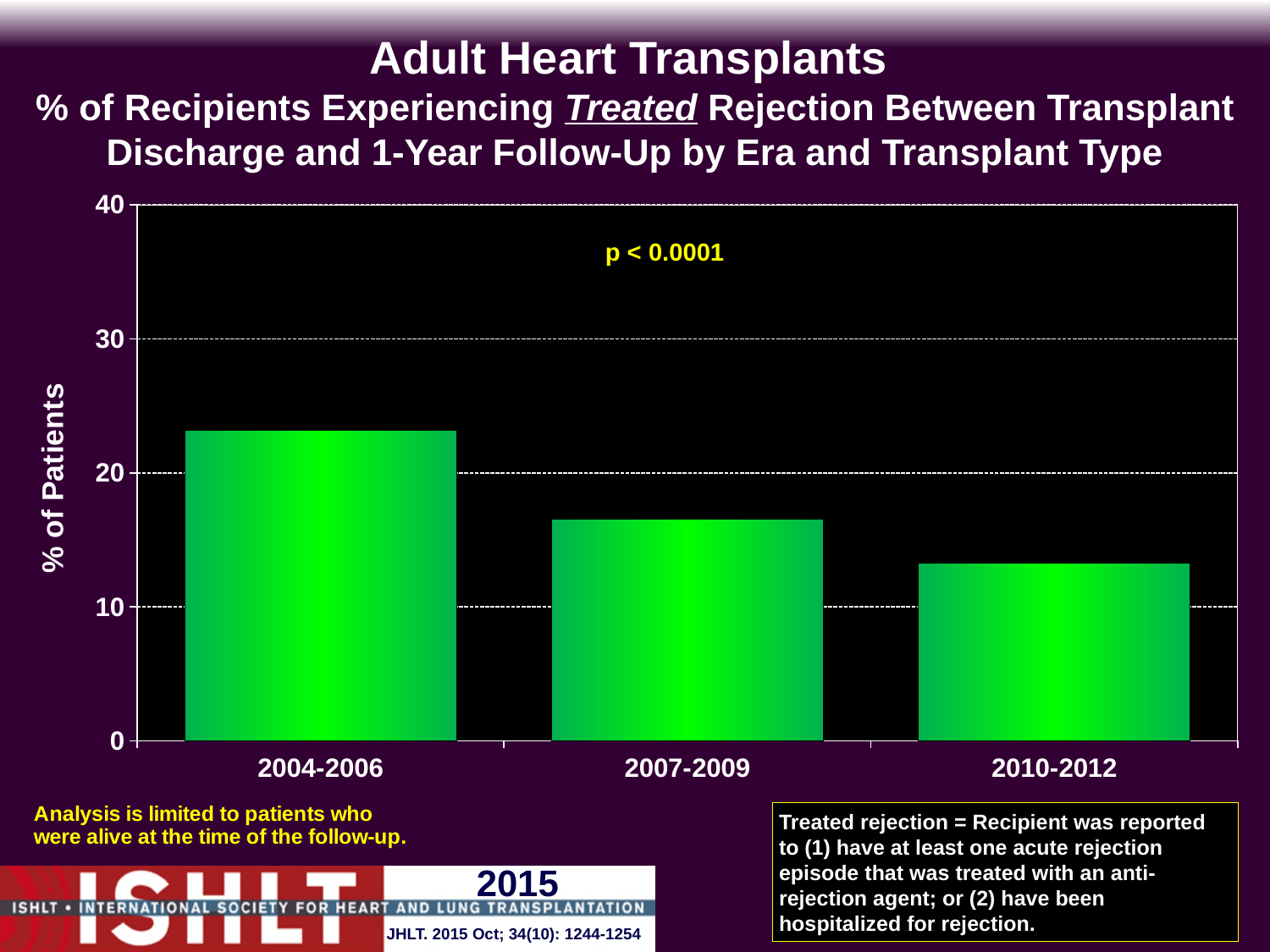
Which era has a larger value, 2004-2006 or 2007-2009? 2004-2006 What is the label of the y axis? % of Patients How many eras (categories) are plotted on the x axis? 3 Do the values rise or fall across the eras from 2004-2006 to 2010-2012? fall Is the value for 2010-2012 greater or less than 10? greater Which era has the highest percentage of patients experiencing treated rejection? 2004-2006 Which era has the lowest percentage of patients experiencing treated rejection? 2010-2012 What kind of chart is shown on the slide? bar chart Is the value for 2004-2006 greater or less than 20? greater Is the value for 2007-2009 greater or less than 20? less What p-value is printed on the chart? p < 0.0001 Which era has a larger value, 2007-2009 or 2010-2012? 2007-2009